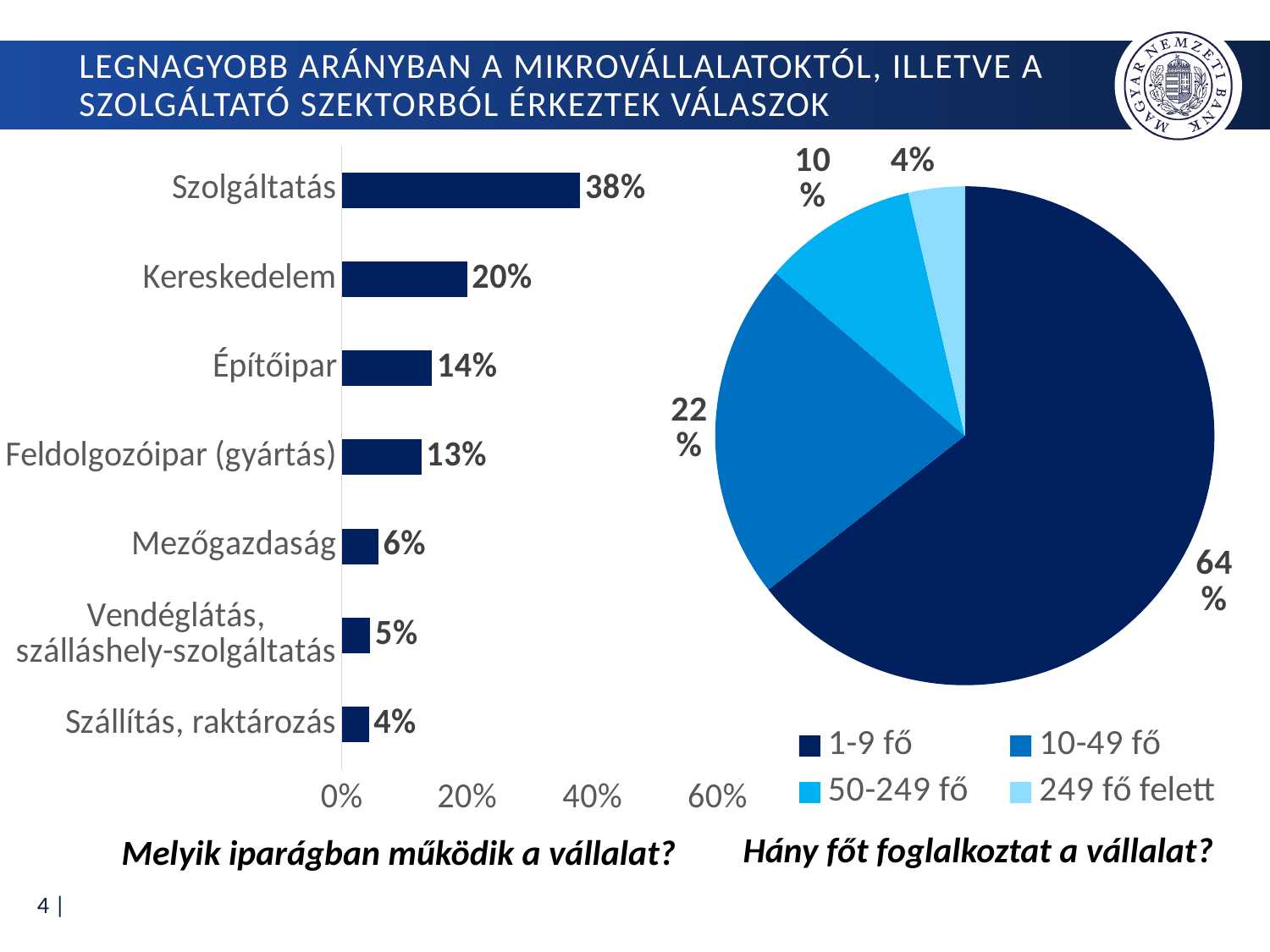
What kind of chart is the chart on the left of the slide? Bar chart In the pie chart on the right, what is the value for 10-49 fő? 22% In the bar chart on the left, how many categories are shown? 7 In the bar chart on the left, what is the value for Feldolgozóipar (gyártás)? 13% In the pie chart on the right (Hány főt foglalkoztat a vállalat?), what share does the 1-9 fő slice have? 64% In the pie chart on the right, which slice is the smallest? 249 fő felett In the bar chart on the left, what is the difference between Szolgáltatás and Kereskedelem? 18% In the bar chart on the left, which category has the highest value? Szolgáltatás In the bar chart on the left (Melyik iparágban működik a vállalat?), what is the value for Szolgáltatás? 38% In the pie chart on the right, how many entries does the legend list? 4 In the bar chart on the left, which category has the lowest value? Szállítás, raktározás In the bar chart on the left, which is larger, Építőipar or Mezőgazdaság? Építőipar